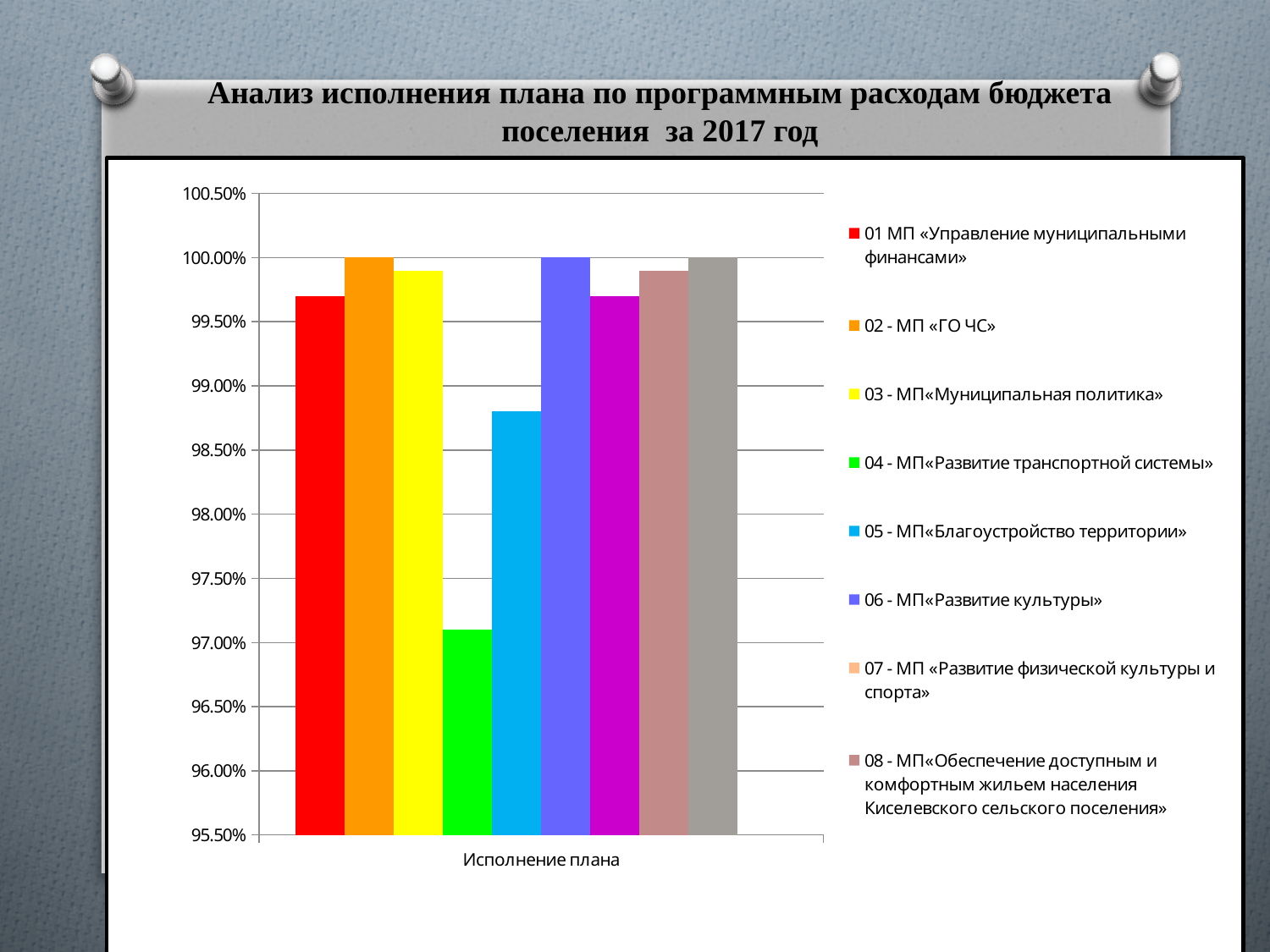
What is the value for 06 - МП«Развитие культуры»? 100.00% Which is larger, the value for 05 - МП«Благоустройство территории» or for 04 - МП«Развитие транспортной системы»? 05 - МП«Благоустройство территории» Is the value for 01 МП «Управление муниципальными финансами» greater or less than 99.50%? greater What label is shown under the x axis of the chart? Исполнение плана Which is larger, the value for 02 - МП «ГО ЧС» or for 05 - МП«Благоустройство территории»? 02 - МП «ГО ЧС» What is the title of the slide? Анализ исполнения плана по программным расходам бюджета поселения за 2017 год What is the value for 02 - МП «ГО ЧС»? 100.00% Which programme has the lowest plan execution value? 04 - МП«Развитие транспортной системы» Is the value for 05 - МП«Благоустройство территории» greater or less than 98.50%? greater What kind of chart is shown on the slide? bar chart How many bars are plotted in the chart? 9 Is the value for 04 - МП«Развитие транспортной системы» greater or less than 97.50%? less